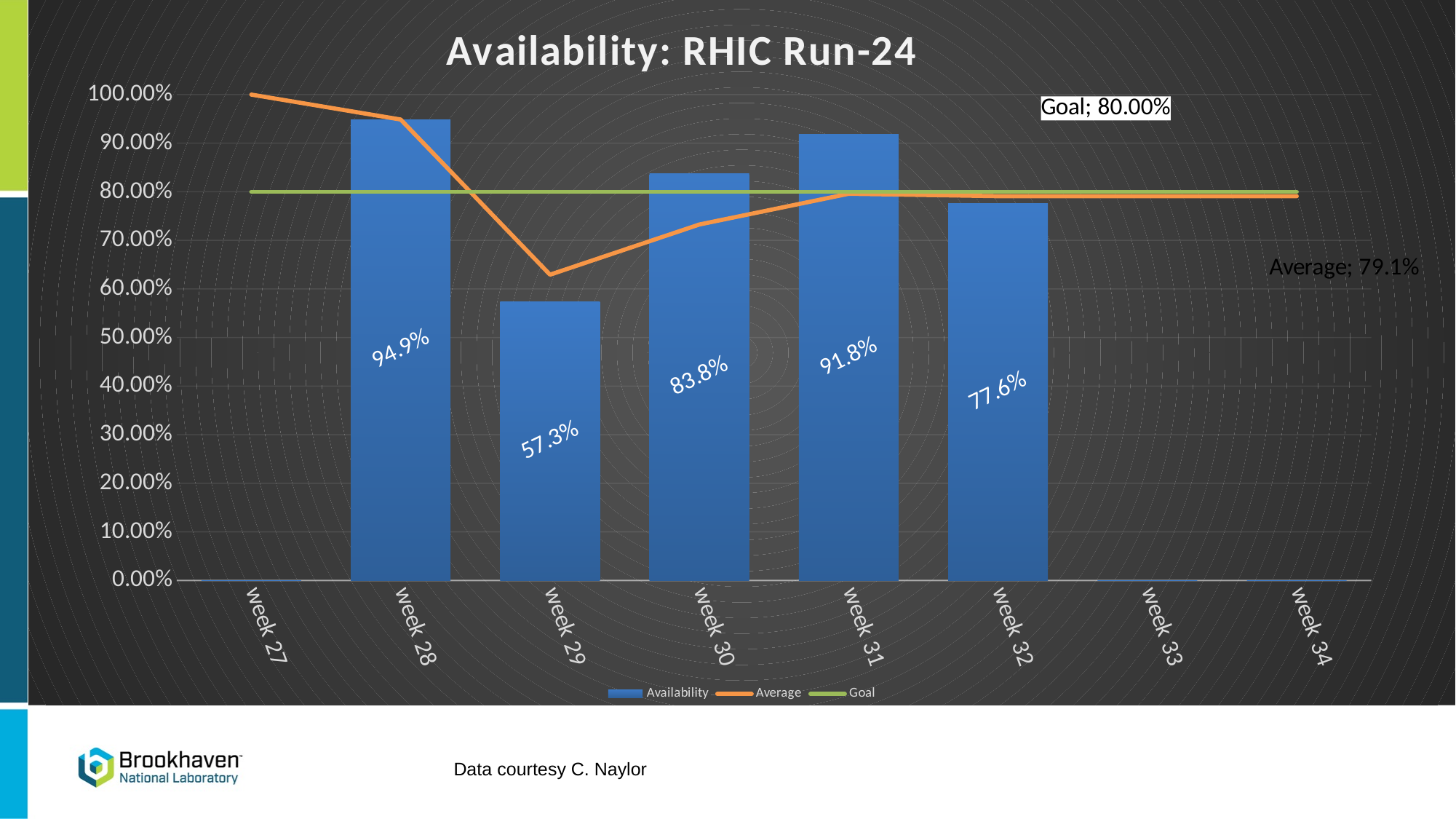
What is the difference between the availability for week 28 and week 29? 37.6% How many series does the legend list? 3 Which has the higher availability, week 30 or week 31? week 31 What value is shown for the Average label? 79.1% Which week has the lowest availability bar? week 29 How many weeks have an availability bar plotted? 5 Which week has the highest availability bar? week 28 Is the availability for week 29 greater or less than 60.00%? less What is the availability for week 32? 77.6% What value is shown for the Goal line? 80.00% What is the availability for week 29? 57.3% What is the availability for week 28? 94.9%